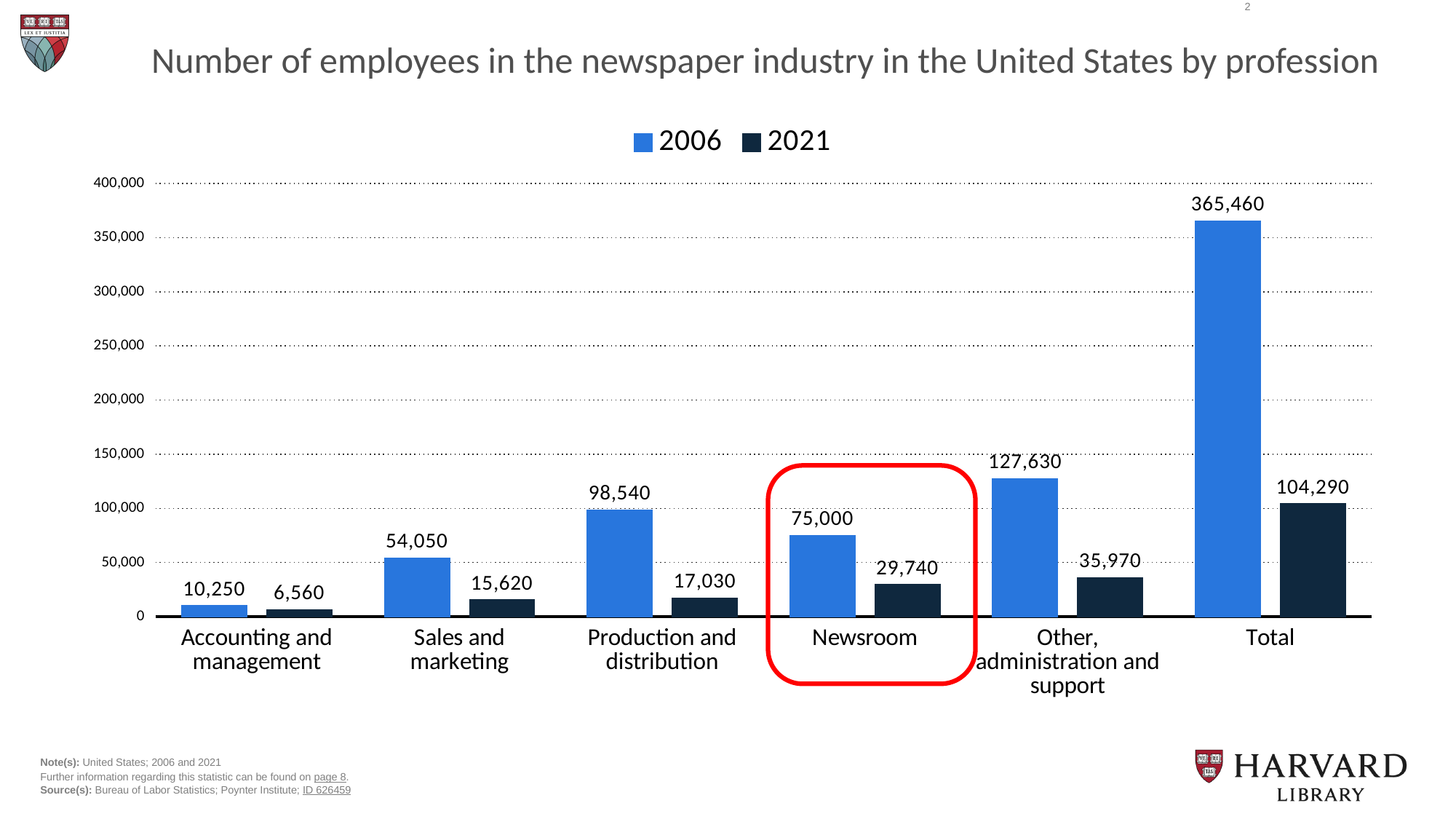
What is the difference between the 2006 and 2021 values for Newsroom? 45,260 What was the number of newsroom employees in 2006? 75,000 What was the number of newsroom employees in 2021? 29,740 How many series does the legend list? 2 Which is larger: the 2021 value for Other, administration and support or the 2021 value for Newsroom? Other, administration and support What was the 2006 value for Production and distribution? 98,540 What is the difference between the 2006 and 2021 Total values? 261,170 Which profession had the fewest employees in 2021? Accounting and management What kind of chart is shown on the slide? Bar chart What was the 2021 value for Sales and marketing? 15,620 How many categories are shown on the x axis? 6 Excluding Total, which profession had the most employees in 2006? Other, administration and support